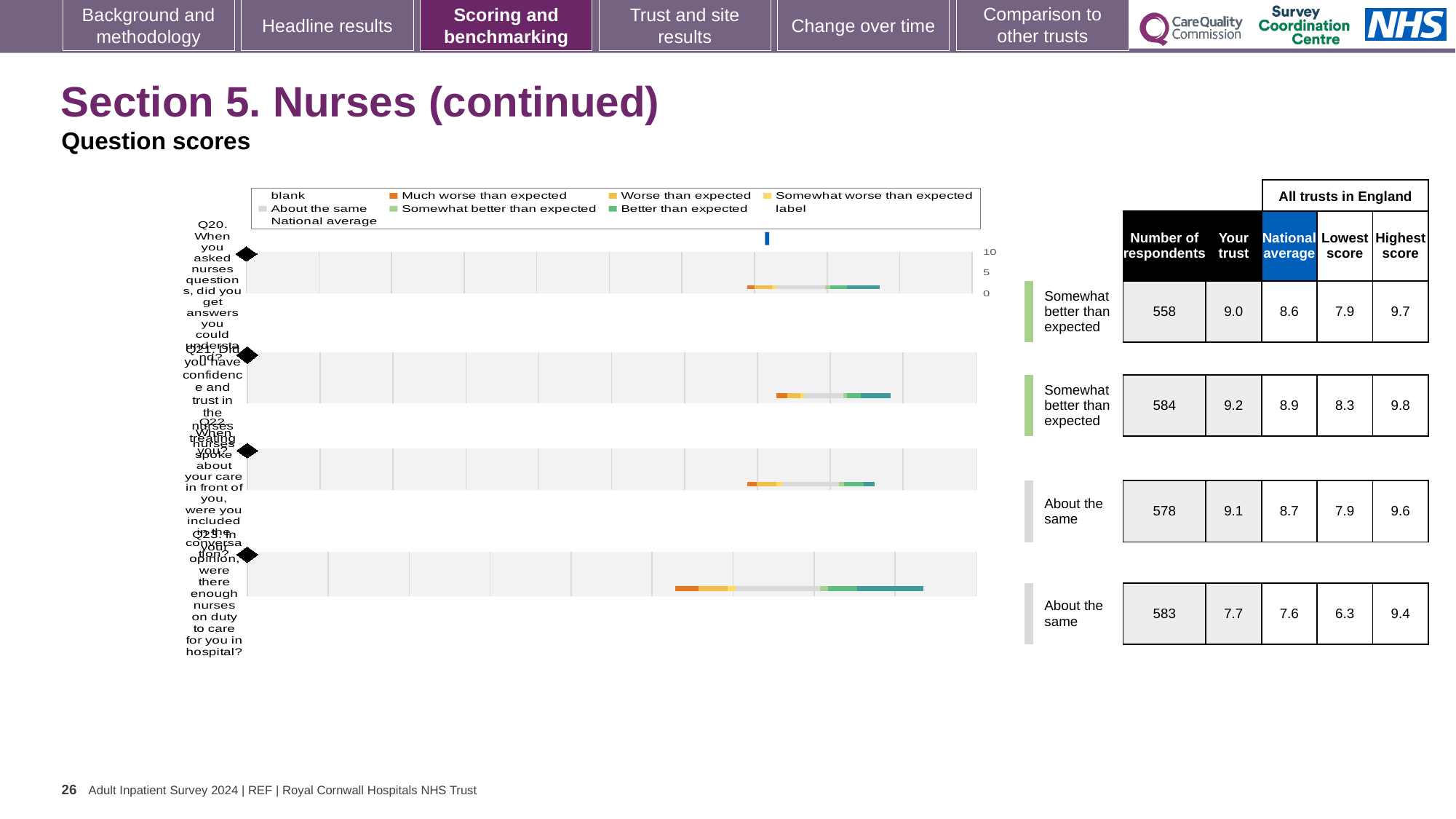
How many respondents answered Q20 (did you get answers you could understand)? 558 Which question has the lowest 'Your trust' score? Q23 What benchmark category is shown for Q21? Somewhat better than expected What is the 'Your trust' score for Q23 (were there enough nurses on duty)? 7.7 What kind of chart is shown on the slide? bar chart What is the difference between the 'Your trust' score and the national average for Q20? 0.4 Which question has the highest 'Your trust' score? Q21 For Q22, which is larger: the 'Your trust' score or the national average? Your trust What is the national average score for Q21 (confidence and trust in the nurses)? 8.9 How many questions (categories) are plotted in the chart? 4 What is the highest score among all trusts in England for Q23? 9.4 What is the lowest score among all trusts in England for Q21? 8.3